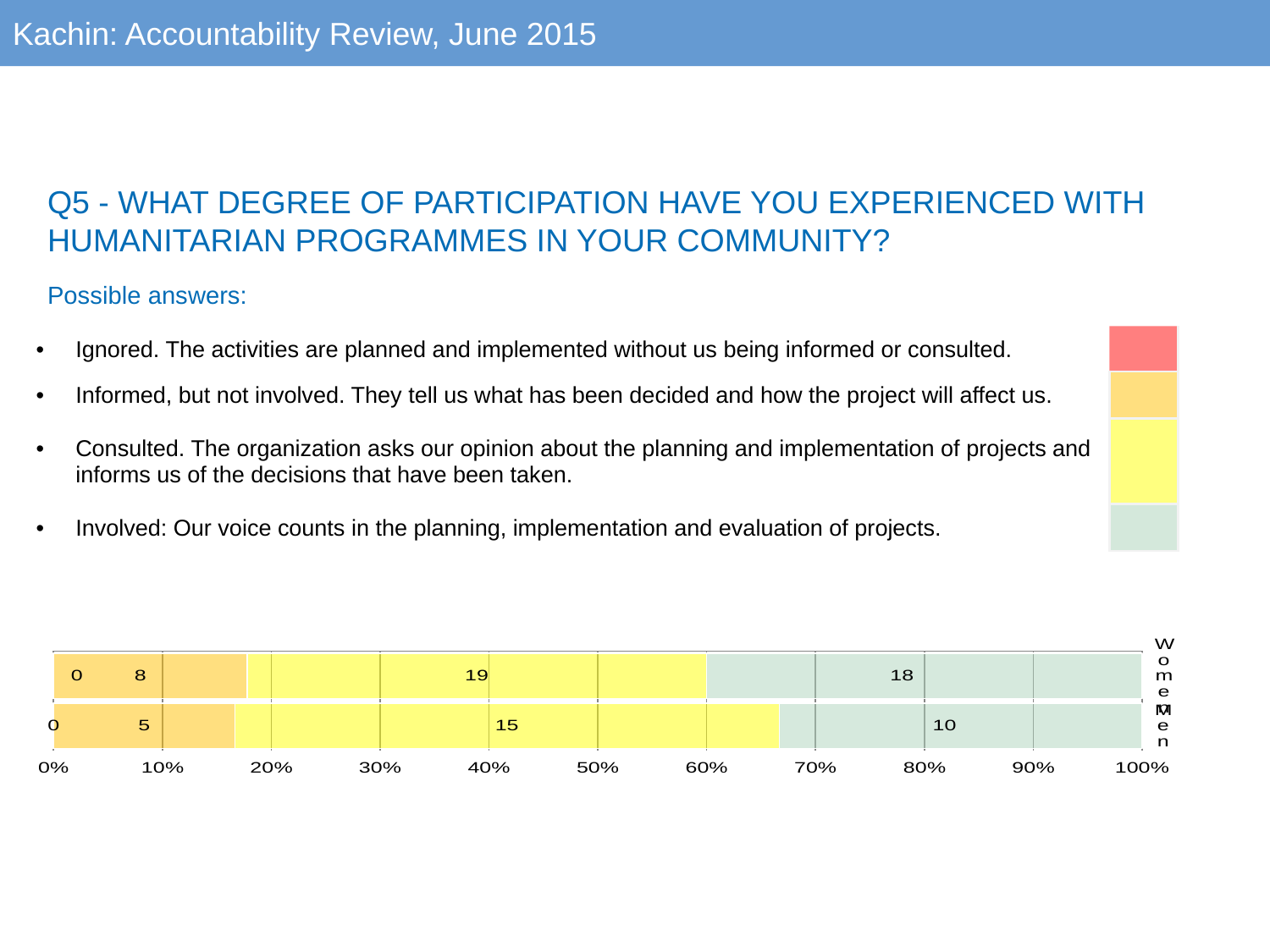
What is the total of all segments in the Men bar? 30 What is the total of all segments in the Women bar? 45 What is the value of the yellow segment in the Women bar? 19 What is the value of the yellow segment in the Men bar? 15 How many bars (categories) does the chart show? 2 What is the value of the orange segment in the Women bar? 8 Which segment has the highest value in the Women bar? the yellow segment (19) What kind of chart is shown at the bottom of the slide? bar chart What is the difference between the yellow segment values for Women and Men? 4 What is the value of the green segment in the Men bar? 10 How many colour entries does the colour key on the right of the slide show? 4 Which bar has the larger green segment value, Women or Men? Women